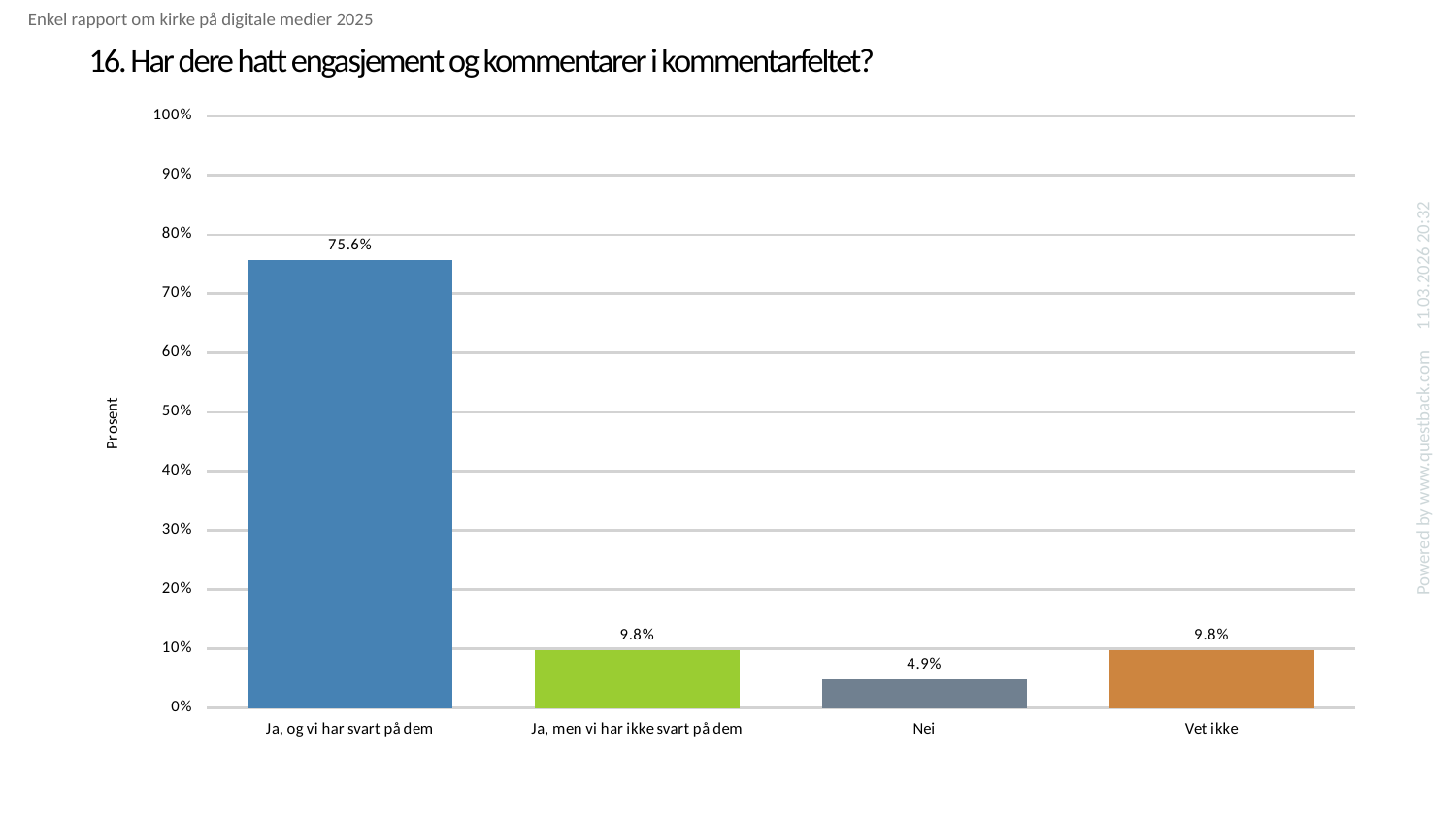
What is the value for "Nei"? 4.9% What is the label of the y axis? Prosent How many categories are shown on the x axis? 4 Is the value for "Ja, og vi har svart på dem" greater or less than 70%? greater What is the value for "Ja, og vi har svart på dem"? 75.6% Which is larger, the value for "Vet ikke" or the value for "Nei"? Vet ikke What kind of chart is shown on the slide? bar chart What is the difference between the values for "Ja, og vi har svart på dem" and "Nei"? 70.7% What is the value for "Ja, men vi har ikke svart på dem"? 9.8% Which category has the lowest value? Nei Which category has the highest value? Ja, og vi har svart på dem What is the value for "Vet ikke"? 9.8%